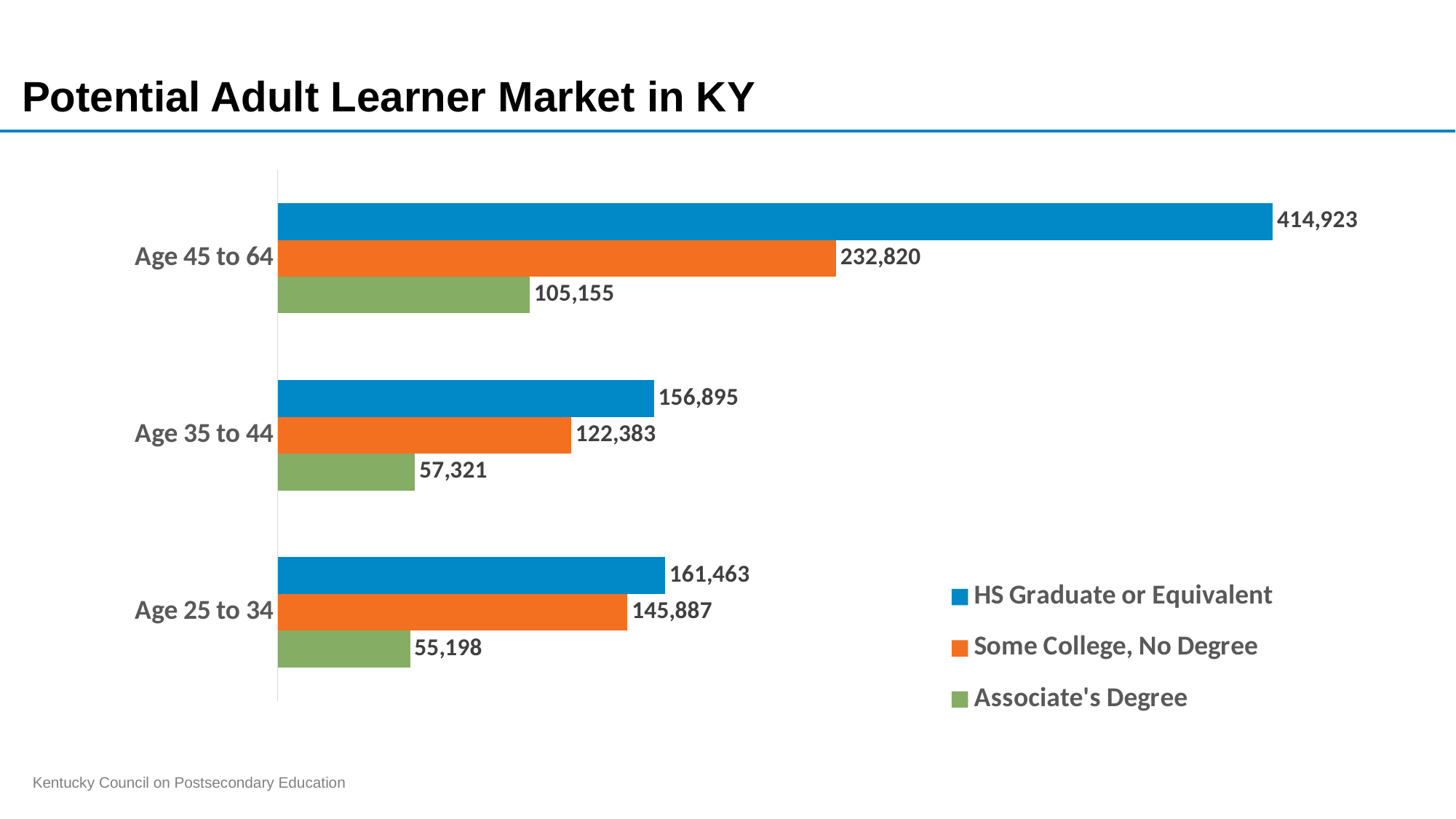
How many series does the legend list? 3 What is the difference between the HS Graduate or Equivalent values for Age 45 to 64 and Age 35 to 44? 258,028 Which age group has the highest value for Some College, No Degree? Age 45 to 64 Which age group has the lowest value for Associate's Degree? Age 25 to 34 What is the value for Some College, No Degree in the Age 25 to 34 group? 145,887 What kind of chart is shown on the slide? Bar chart How many age groups are shown on the chart? 3 Which is larger: the HS Graduate or Equivalent value for Age 25 to 34 or for Age 35 to 44? Age 25 to 34 What is the value for Associate's Degree in the Age 35 to 44 group? 57,321 Which colour represents Associate's Degree in the legend? Green What is the value for HS Graduate or Equivalent in the Age 45 to 64 group? 414,923 What is the title of the chart? Potential Adult Learner Market in KY